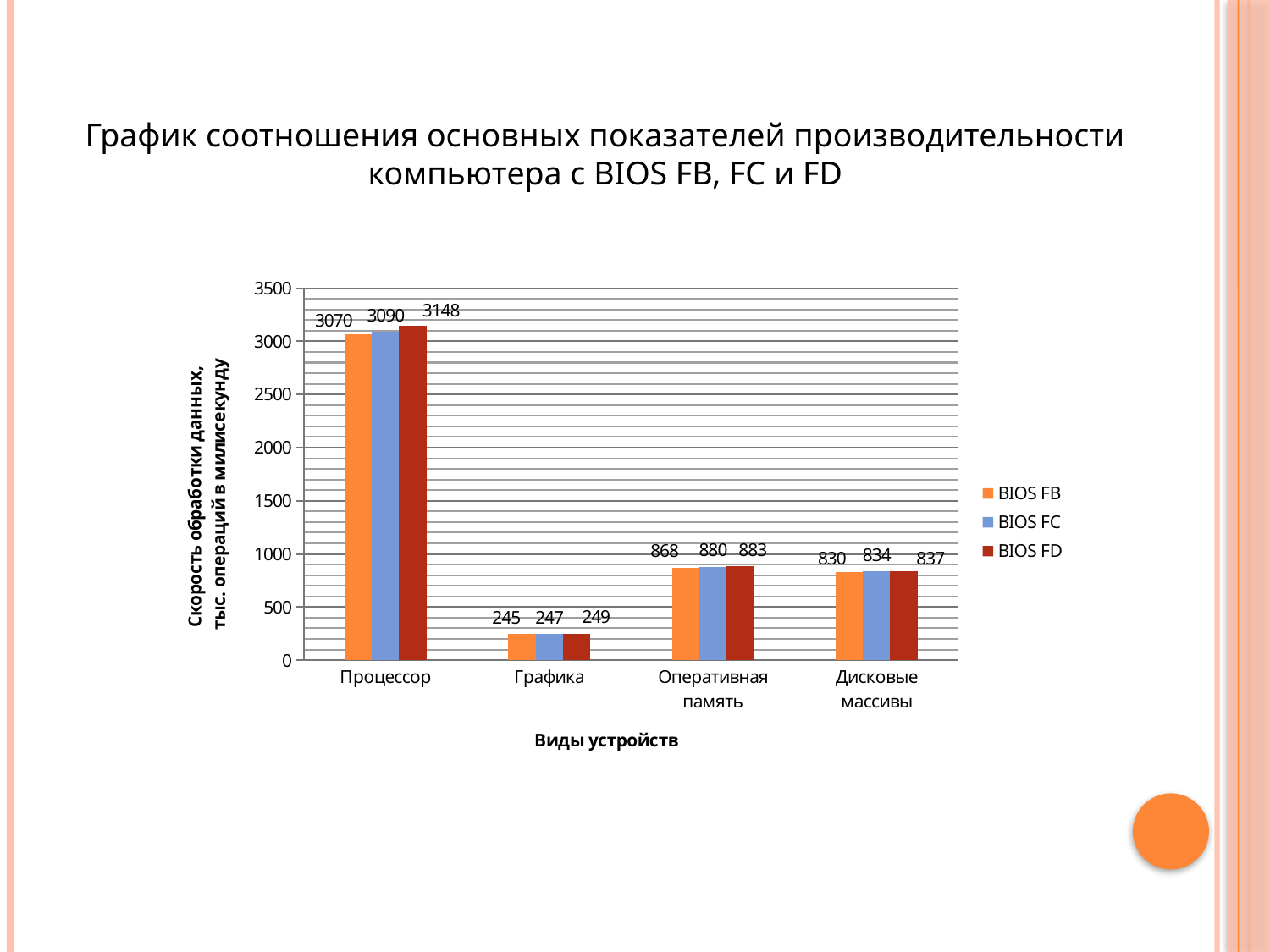
What is the difference between the BIOS FD and BIOS FB values for Процессор? 78 What kind of chart is shown on the slide? Bar chart What is the difference between the BIOS FC and BIOS FB values for Дисковые массивы? 4 What is the value for BIOS FB in the Графика category? 245 What is the value for BIOS FD in the Дисковые массивы category? 837 Which category has the lowest values across all series? Графика How many series does the legend list? 3 Which is larger: the BIOS FB value for Оперативная память or the BIOS FD value for Дисковые массивы? BIOS FB value for Оперативная память How many categories are shown on the x axis? 4 What is the value for BIOS FC in the Оперативная память category? 880 What is the value for BIOS FD in the Процессор category? 3148 Which category has the highest values across all series? Процессор